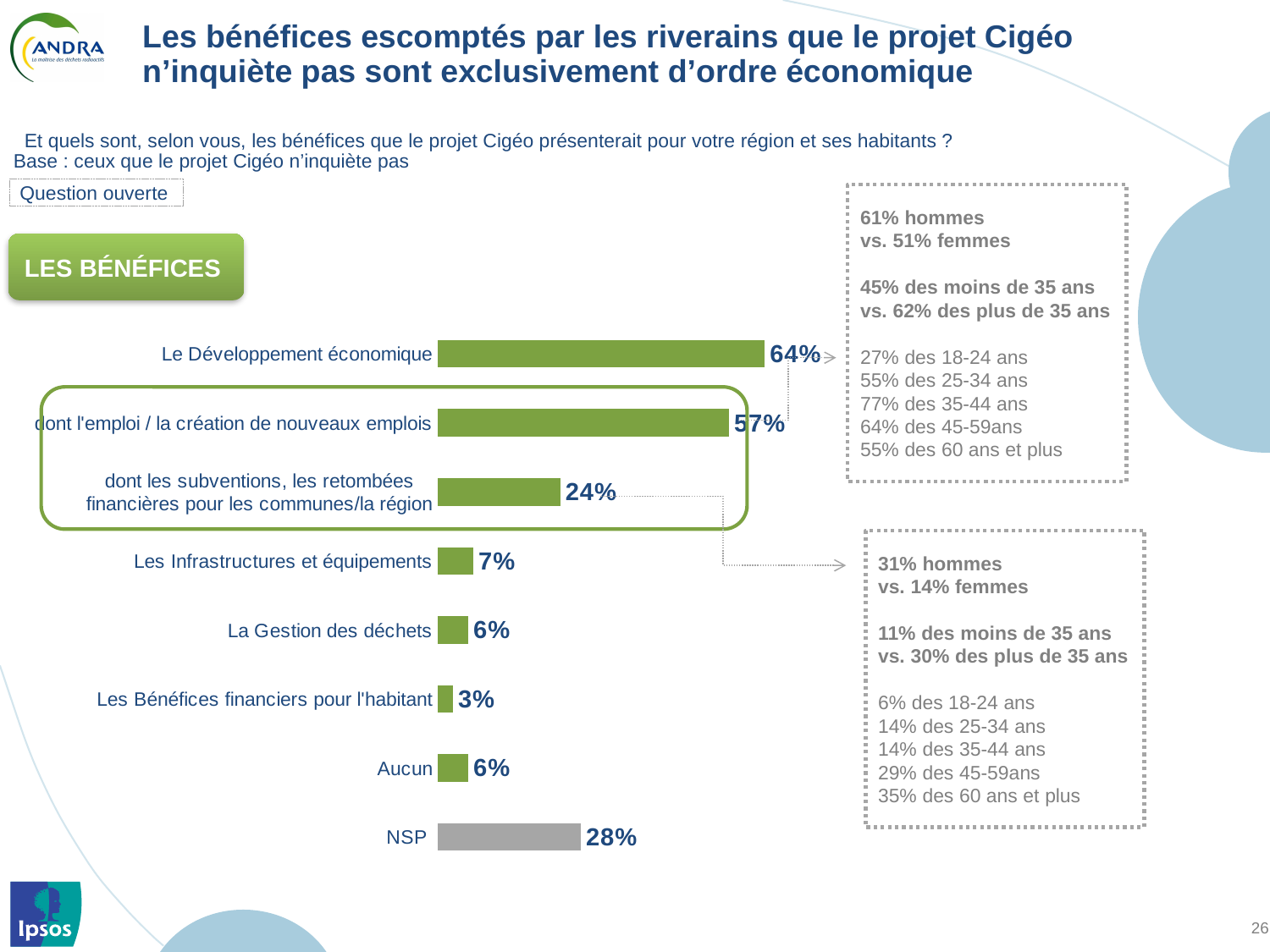
Which is larger, "Les Infrastructures et équipements" or "La Gestion des déchets"? Les Infrastructures et équipements How many categories are shown in the bar chart? 8 What colour is the bar for "NSP"? Grey Which category has the highest value? Le Développement économique What is the value for "Les Bénéfices financiers pour l'habitant"? 3% What is the difference between "Le Développement économique" and "NSP"? 36% Which category has the lowest value? Les Bénéfices financiers pour l'habitant What is the value for "dont l'emploi / la création de nouveaux emplois"? 57% What is the value for "NSP"? 28% What is the value for "Le Développement économique"? 64% What is the value for "dont les subventions, les retombées financières pour les communes/la région"? 24% What kind of chart is shown on the slide? Bar chart